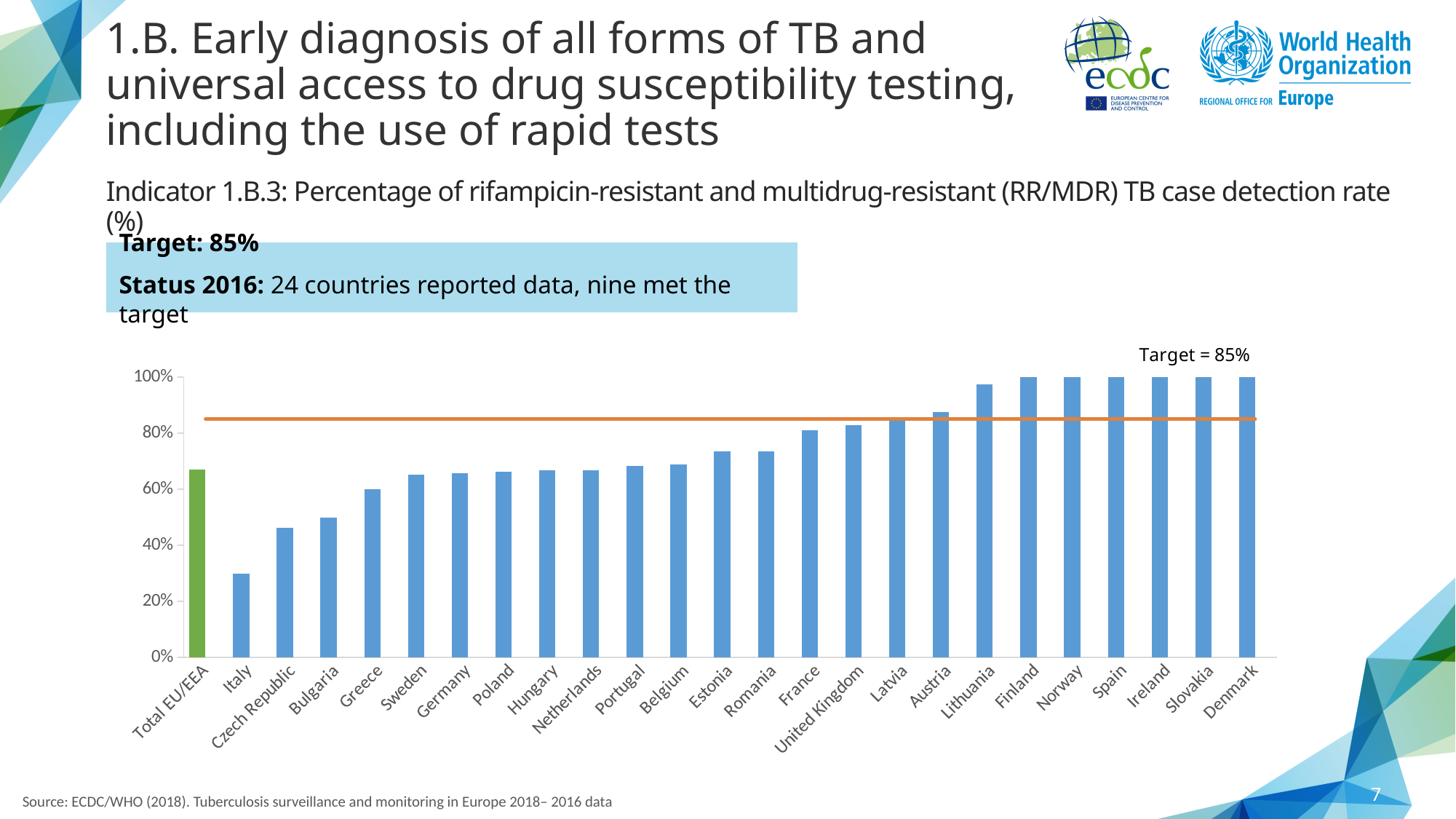
Is the value for Italy greater or less than 40%? less What is the RR/MDR TB case detection rate for Finland? 100% Do the country values rise or fall moving from left to right along the x axis? rise Which has a higher case detection rate, Czech Republic or Greece? Greece Which bar in the chart is coloured green rather than blue? Total EU/EEA Which country has the lowest RR/MDR TB case detection rate in the chart? Italy Is the value for Total EU/EEA greater or less than 60%? greater What value does the horizontal target line in the chart represent? 85% How many countries are plotted in the chart, excluding the Total EU/EEA bar? 24 What kind of chart is shown on the slide? bar chart Is the value for France greater or less than 85%? less